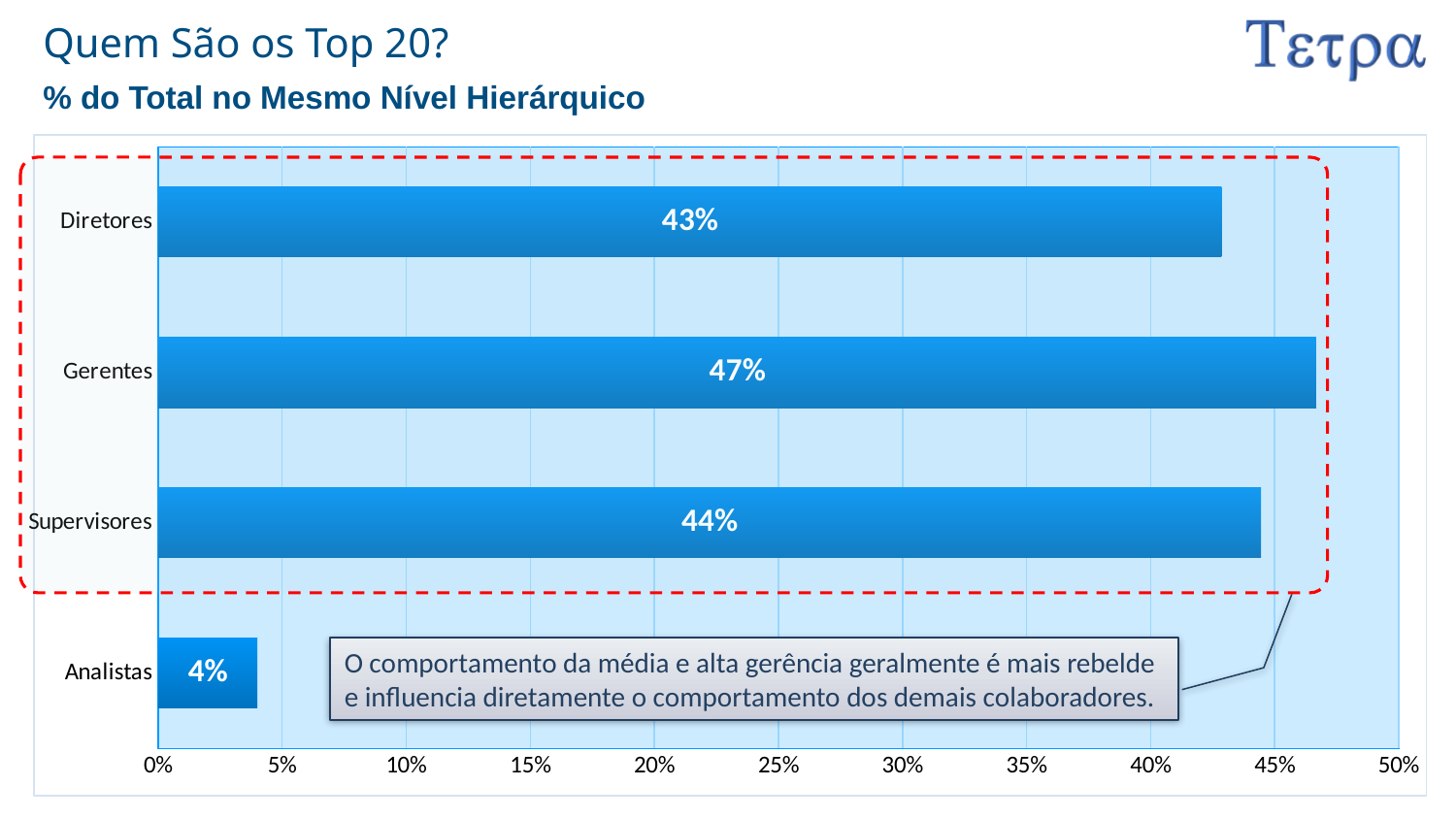
What kind of chart is shown on the slide? Bar chart What is the difference between the values for Gerentes and Diretores? 4% What is the value for Supervisores? 44% What is the value for Gerentes? 47% What is the value for Analistas? 4% What is the value for Diretores? 43% How many categories are shown in the chart? 4 Is the value for Gerentes greater or less than 45%? greater What is the difference between the values for Supervisores and Analistas? 40% Which category has the lowest value? Analistas Which category has the highest value? Gerentes Which is larger, the value for Supervisores or the value for Diretores? Supervisores